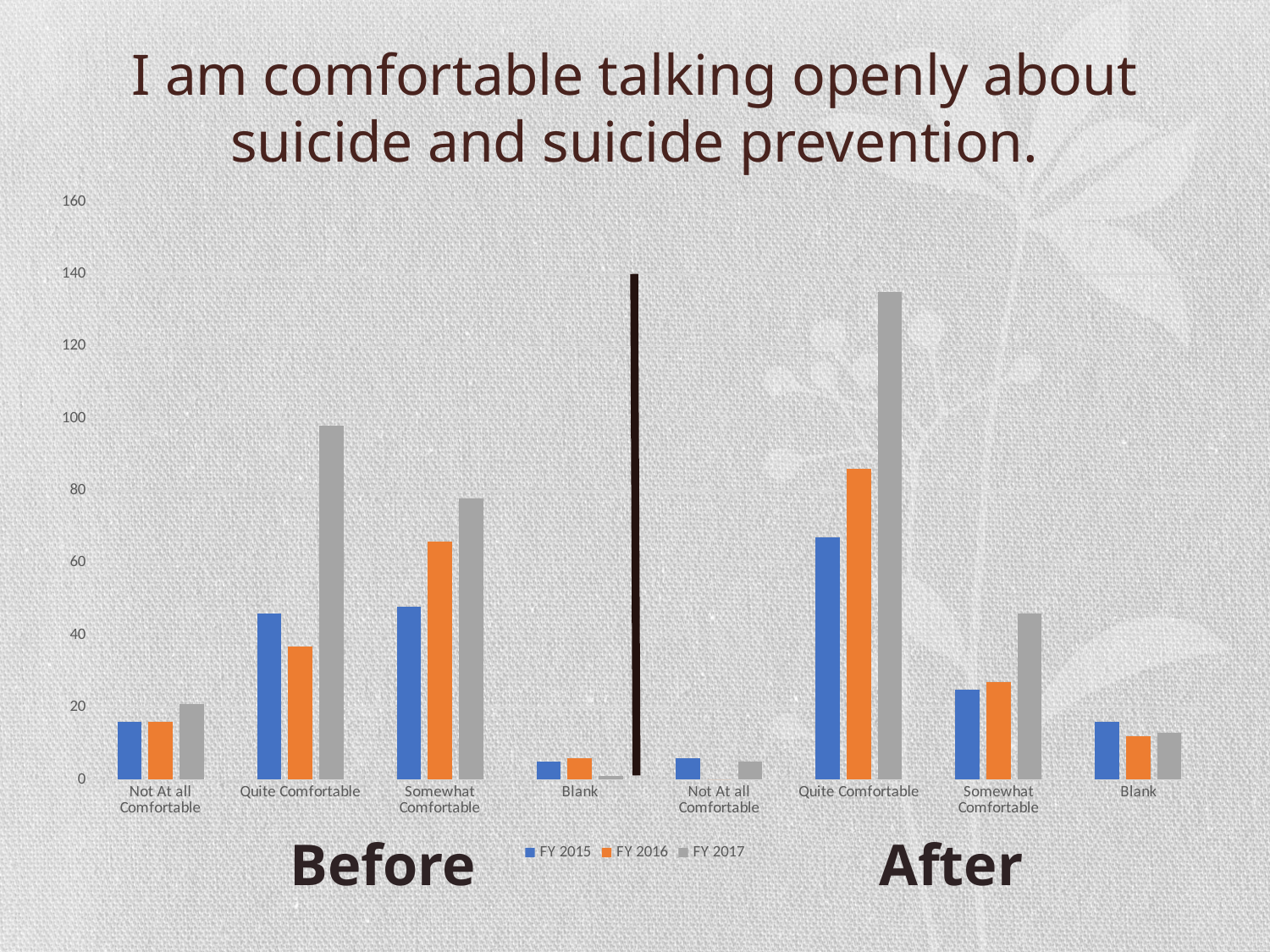
Is the FY 2017 value for Quite Comfortable in the Before section greater or less than 80? greater Is the FY 2016 value for Somewhat Comfortable in the Before section greater or less than 60? greater How many category groups are plotted along the x axis in total? 8 Which category and series has the tallest bar on the chart? Quite Comfortable (After), FY 2017 In the After section, which is larger for Somewhat Comfortable: FY 2017 or FY 2015? FY 2017 Is the FY 2015 value for Quite Comfortable in the After section greater or less than 80? less What kind of chart is shown on the slide? bar chart In the Before section, which is larger for Quite Comfortable: FY 2015 or FY 2016? FY 2015 Which series is shown in grey according to the legend? FY 2017 Which series has the lowest bar for Blank in the Before section? FY 2017 How many series does the legend list? 3